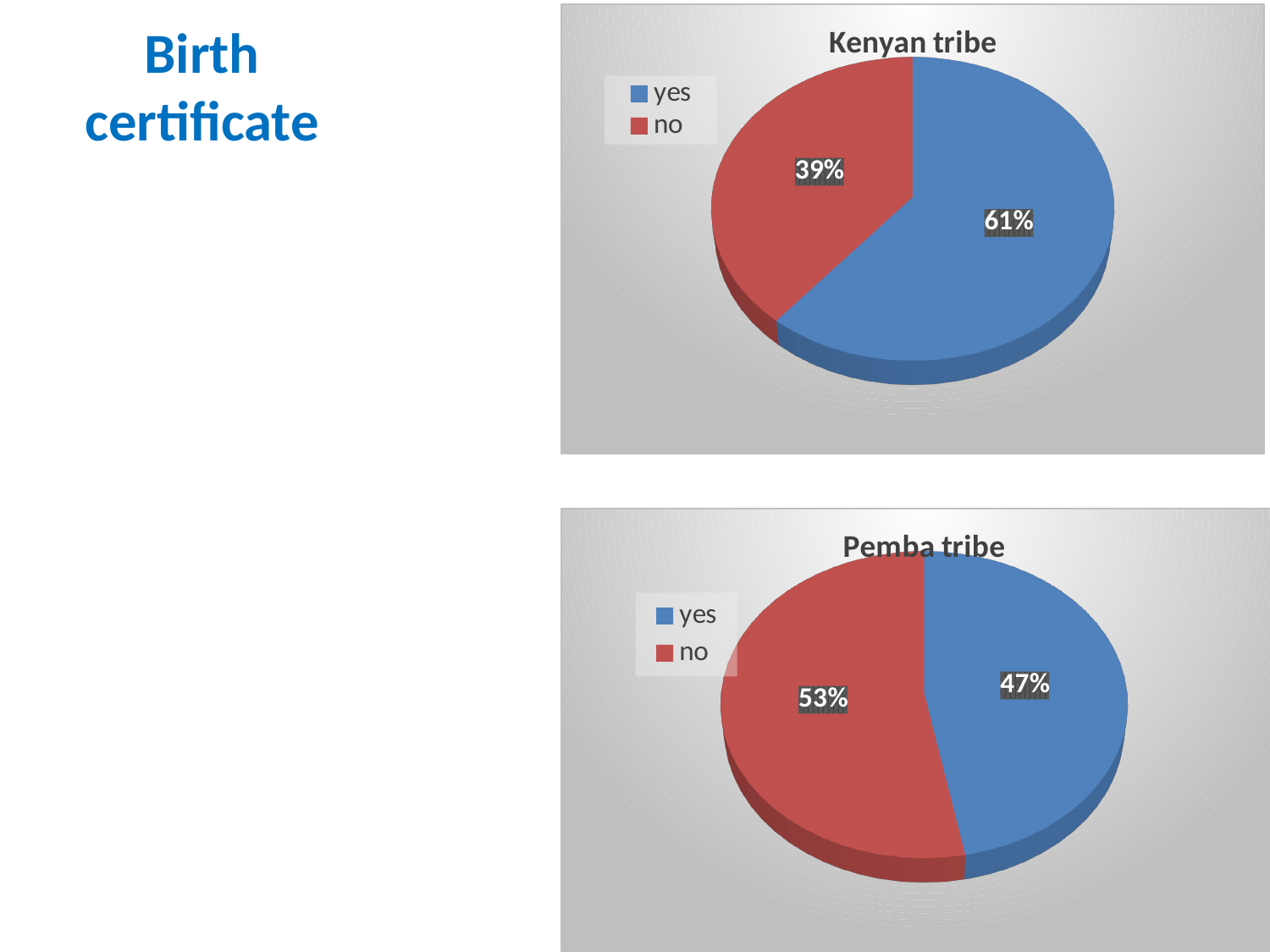
In the Pemba tribe chart, which colour represents "no"? Red In the Kenyan tribe chart, what is the difference between the "yes" and "no" percentages? 22% In the Kenyan tribe chart, what percentage is shown for "no"? 39% In the Kenyan tribe chart, which slice is the largest? yes In the Pemba tribe chart, what percentage is shown for "yes"? 47% In the Kenyan tribe chart, what percentage is shown for "yes"? 61% How many slices does the Pemba tribe chart have? 2 In the Pemba tribe chart, which slice is the smallest? yes What type of chart is the Kenyan tribe chart? Pie chart In the Pemba tribe chart, what is the difference between the "no" and "yes" percentages? 6% In the Pemba tribe chart, what percentage is shown for "no"? 53% Is the "yes" share larger in the Kenyan tribe chart or the Pemba tribe chart? Kenyan tribe